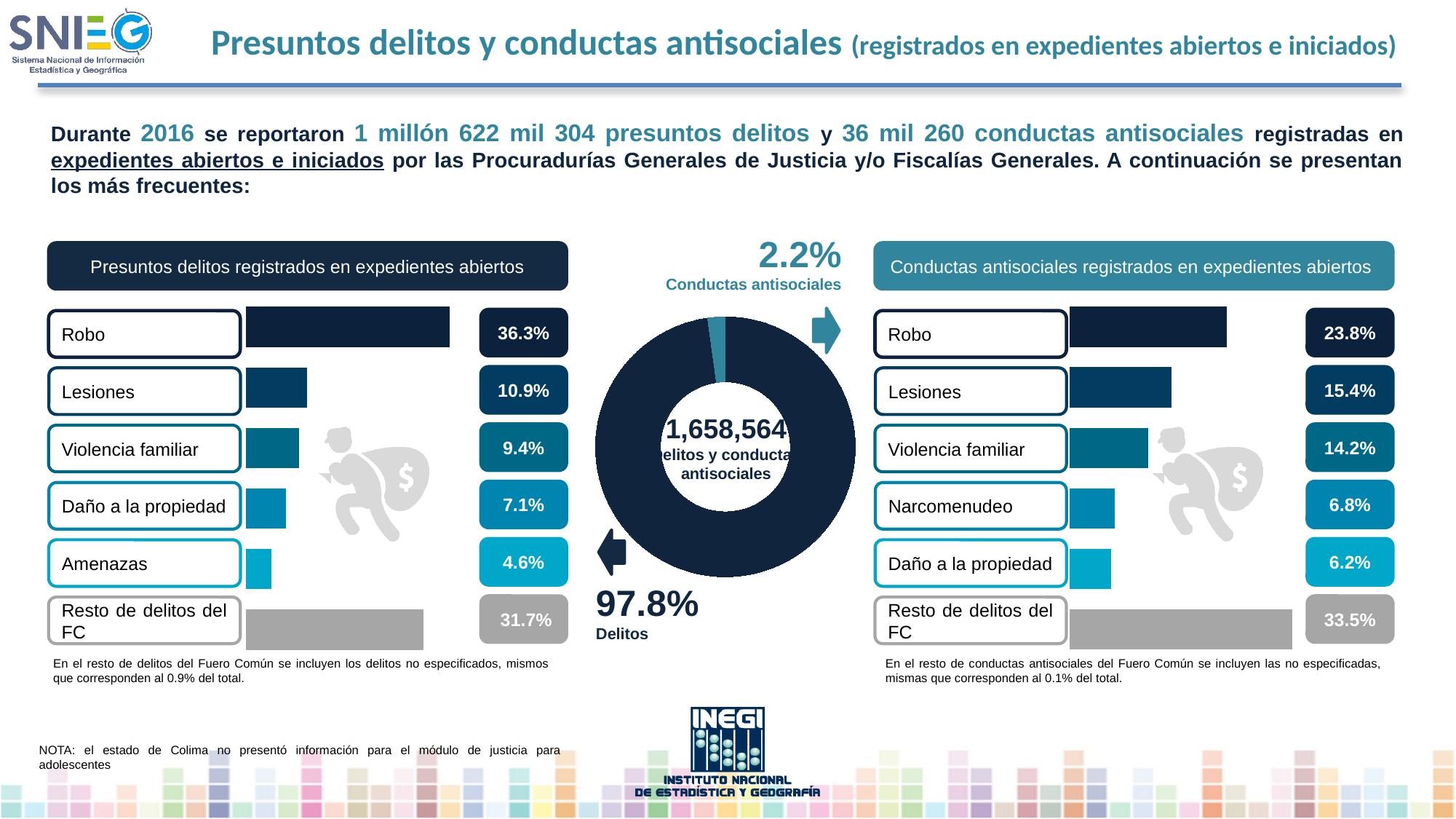
In the chart titled 'Conductas antisociales registrados en expedientes abiertos', what is the value for Violencia familiar? 14.2% In the chart titled 'Presuntos delitos registrados en expedientes abiertos', what is the value for Amenazas? 4.6% In the chart titled 'Presuntos delitos registrados en expedientes abiertos', which named category (excluding 'Resto de delitos del FC') has the highest value? Robo In the chart titled 'Conductas antisociales registrados en expedientes abiertos', what is the value for Narcomenudeo? 6.8% In the chart titled 'Conductas antisociales registrados en expedientes abiertos', which category has the lowest value? Daño a la propiedad What total is shown in the centre of the donut chart? 1,658,564 Which is larger: the value for Daño a la propiedad in the 'Presuntos delitos' chart or the value for Daño a la propiedad in the 'Conductas antisociales' chart? Presuntos delitos (7.1%) In the chart titled 'Conductas antisociales registrados en expedientes abiertos', what is the difference between the values for Lesiones and Narcomenudeo? 8.6% In the chart titled 'Presuntos delitos registrados en expedientes abiertos', what is the difference between the values for Robo and Lesiones? 25.4% In the donut chart in the centre of the slide, what share corresponds to Conductas antisociales? 2.2% How many categories are shown in the chart titled 'Conductas antisociales registrados en expedientes abiertos'? 6 In the chart titled 'Presuntos delitos registrados en expedientes abiertos', what is the value for Robo? 36.3%